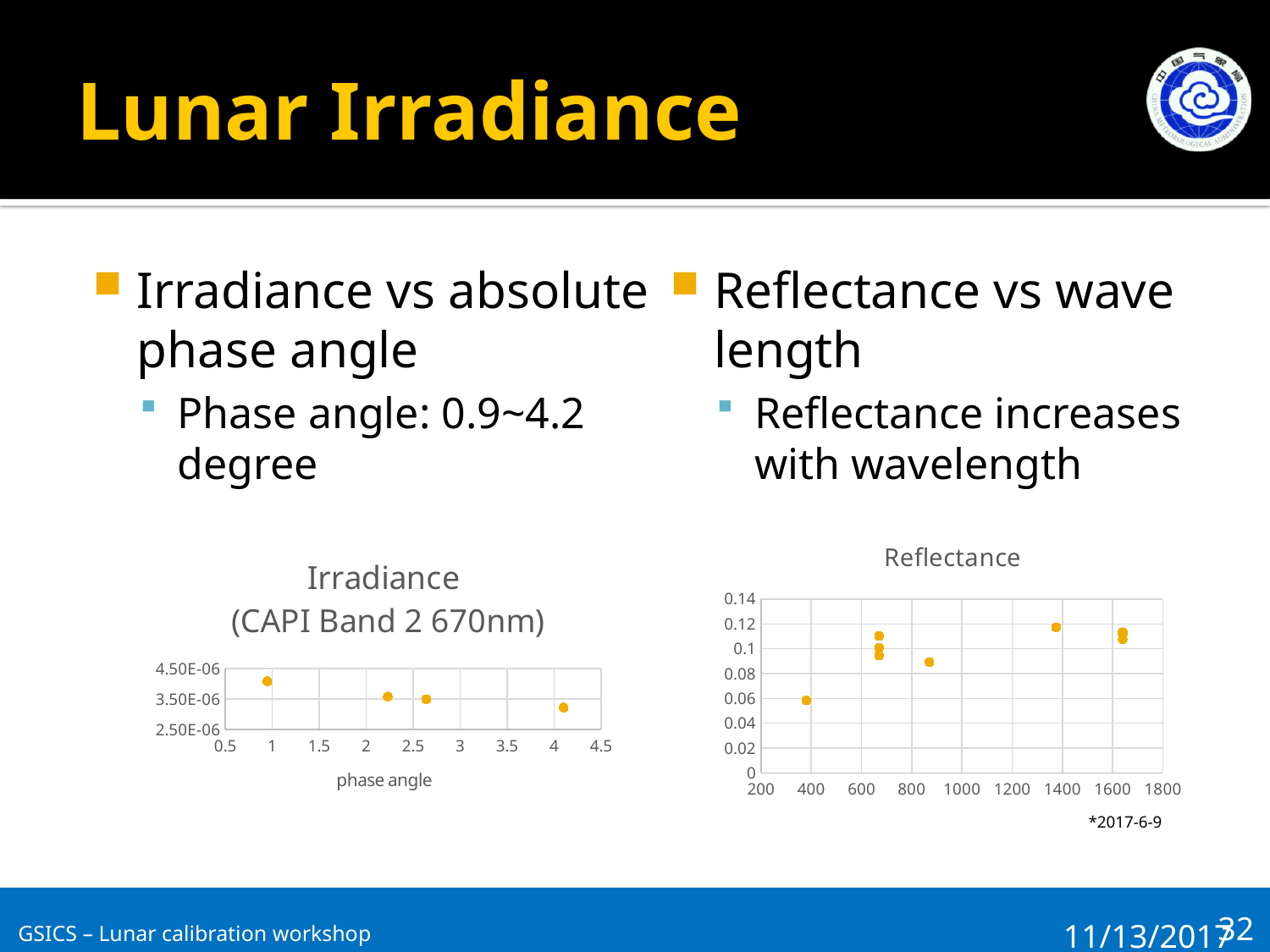
What is the x-axis label of the Irradiance (CAPI Band 2 670nm) chart? phase angle In the Reflectance chart, is the reflectance value at the shortest wavelength (near 400) greater or less than 0.08? less In the Reflectance chart, is the reflectance value at the wavelength near 1400 greater or less than 0.1? greater How many data points are plotted in the Irradiance (CAPI Band 2 670nm) chart? 4 What kind of chart is the Reflectance chart? scatter chart In the Irradiance (CAPI Band 2 670nm) chart, which point has the highest irradiance: the one near phase angle 1 or the one near phase angle 4? the one near phase angle 1 In the Reflectance chart, which wavelength has the lowest reflectance value? the point near 400 What kind of chart is the Irradiance (CAPI Band 2 670nm) chart? scatter chart In the Irradiance (CAPI Band 2 670nm) chart, do the irradiance values rise or fall as phase angle increases? fall In the Irradiance (CAPI Band 2 670nm) chart, is the irradiance value at the smallest phase angle (near 1) greater or less than 3.50E-06? greater In the Reflectance chart, do the reflectance values generally rise or fall as wavelength increases? rise